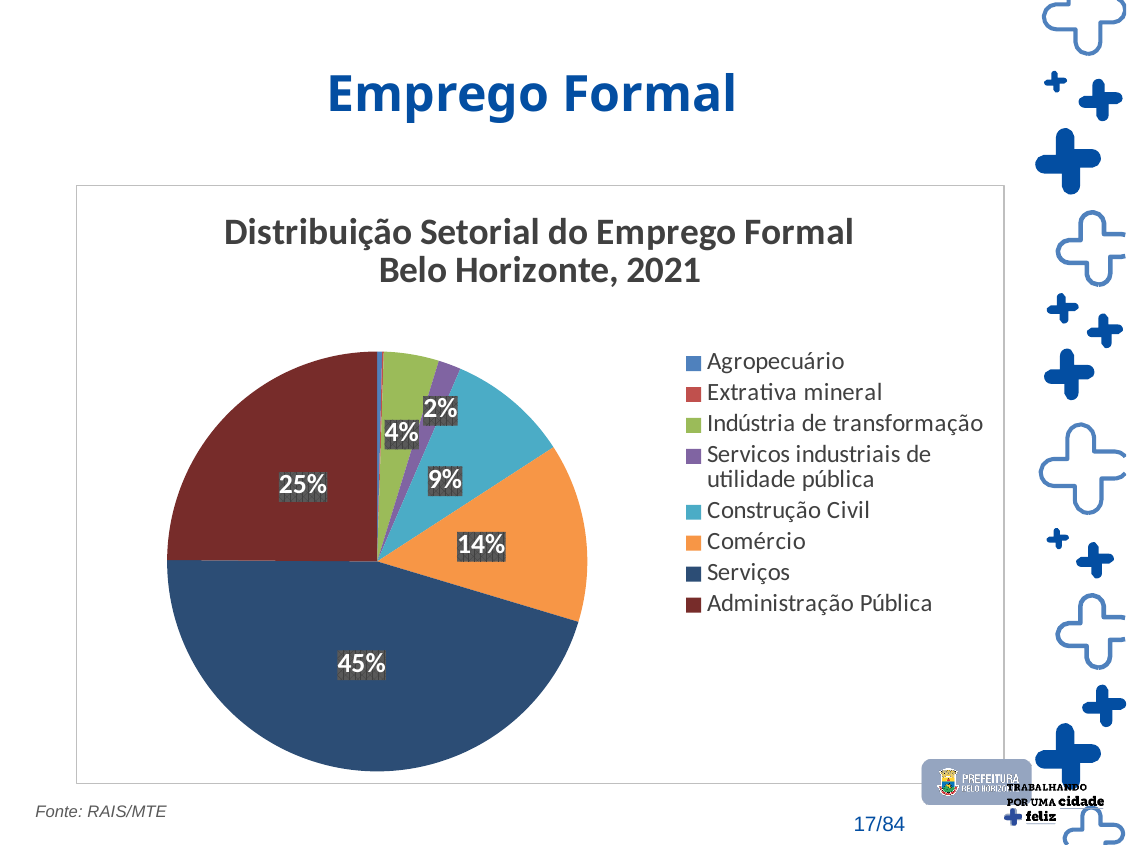
What is the value shown for Serviços industriais de utilidade pública? 2% What share of formal employment does Serviços account for? 45% How many categories does the legend list? 8 What kind of chart is shown on the slide? Pie chart What is the difference between the shares of Serviços and Administração Pública? 20% What is the value shown for Comércio? 14% What share of formal employment does Administração Pública account for? 25% Which is larger, the share for Comércio or the share for Construção Civil? Comércio Which sector has the largest share of formal employment? Serviços What is the title of the chart? Distribuição Setorial do Emprego Formal Belo Horizonte, 2021 What is the value shown for Construção Civil? 9% What is the value shown for Indústria de transformação? 4%